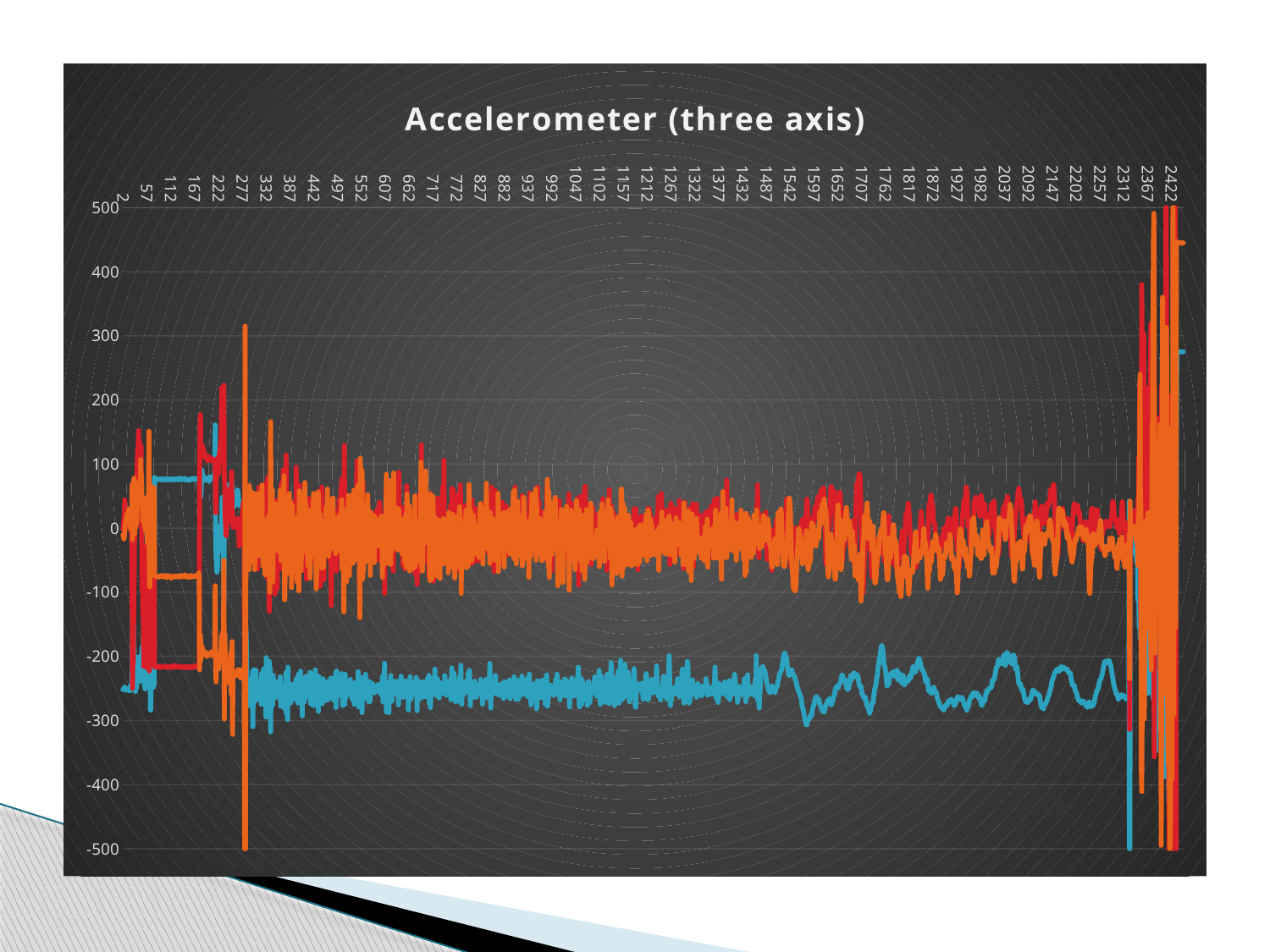
What is the title of the chart? Accelerometer (three axis) Is the value of the blue line at 167 greater or less than 0? greater What is the last label on the horizontal axis? 2422 What kind of chart is shown on the slide? line chart Is the value of the red line at 167 greater or less than -100? less What is the highest value shown on the vertical axis? 500 At 1157, which line has the higher value, the blue line or the orange line? orange line Is the value of the blue line at 1157 greater or less than -300? greater What is the first label on the horizontal axis? 2 What is the lowest value shown on the vertical axis? -500 How many lines (series) are plotted on the chart? 3